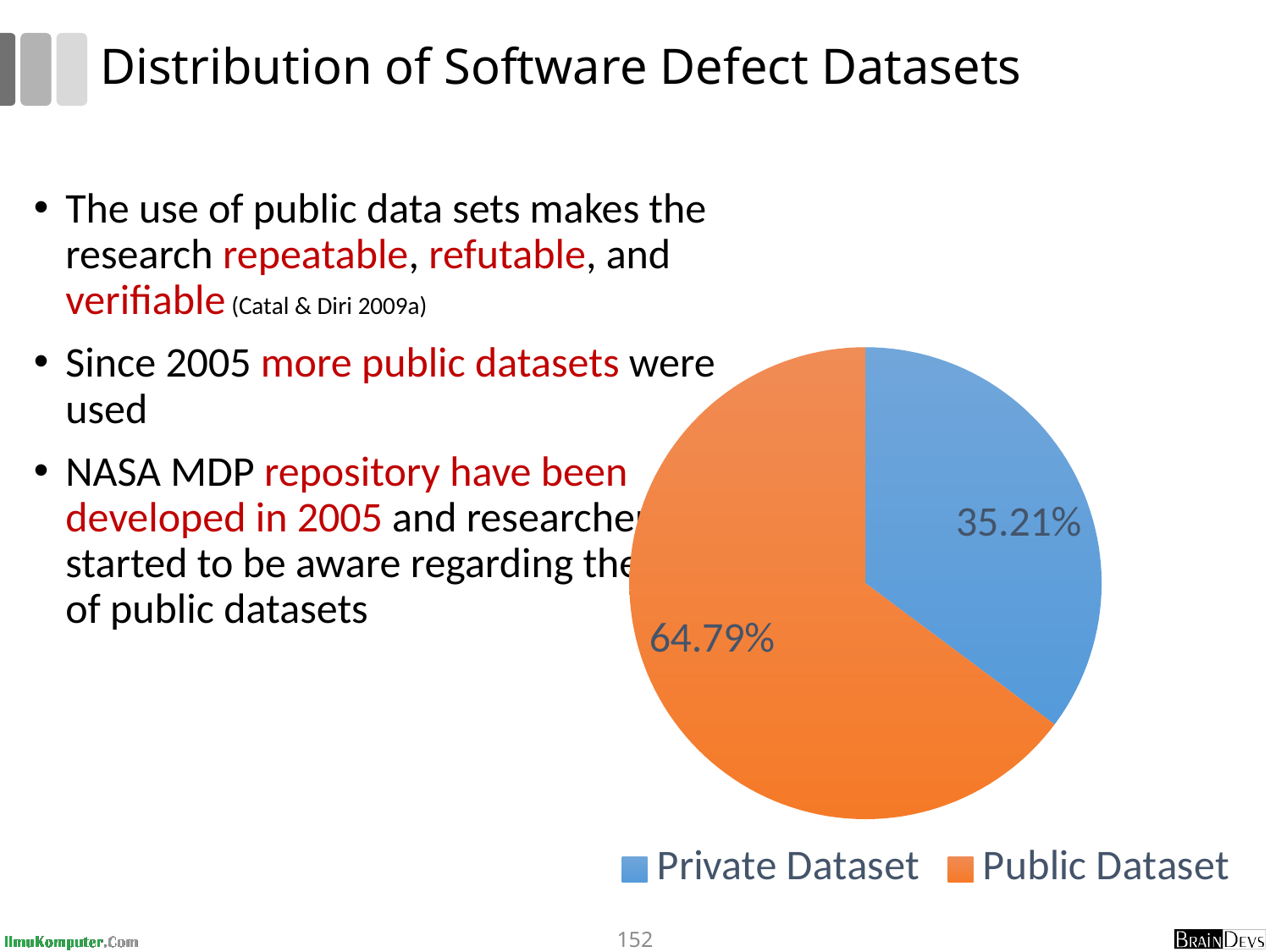
Which category has the smallest share of the pie? Private Dataset What share of the pie does Public Dataset have? 64.79% Which is larger, the share for Private Dataset or the share for Public Dataset? Public Dataset What share of the pie does Private Dataset have? 35.21% What colour is the Public Dataset slice? orange Which category has the largest share of the pie? Public Dataset What is the difference in percentage points between the Public Dataset share and the Private Dataset share? 29.58 How many slices does the pie chart have? 2 What colour is the Private Dataset slice? blue How many entries does the legend list? 2 What kind of chart is shown on the slide? pie chart